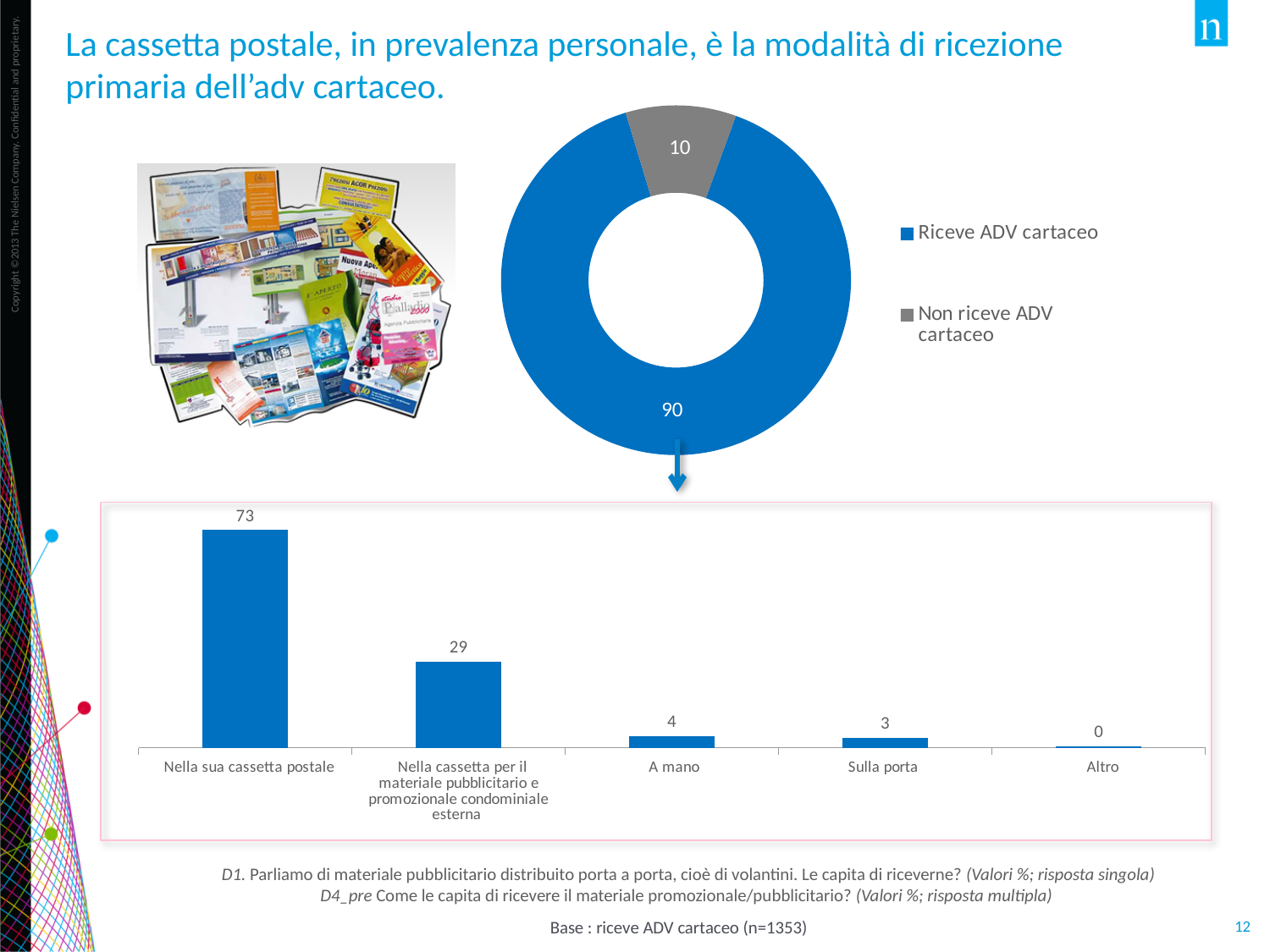
In the bar chart at the bottom of the slide, which category has the highest value? Nella sua cassetta postale In the bar chart at the bottom of the slide, how many categories are shown? 5 In the bar chart at the bottom of the slide, what is the value for "A mano"? 4 In the donut chart at the top of the slide, how many entries does the legend list? 2 What kind of chart is the bottom chart on the slide? Bar chart In the bar chart at the bottom of the slide, what is the difference between "Nella sua cassetta postale" and "Nella cassetta per il materiale pubblicitario e promozionale condominiale esterna"? 44 In the bar chart at the bottom of the slide, which category has the lowest value? Altro In the donut chart at the top of the slide, which segment is larger, "Riceve ADV cartaceo" or "Non riceve ADV cartaceo"? Riceve ADV cartaceo In the donut chart at the top of the slide, what is the value for "Riceve ADV cartaceo"? 90 In the donut chart at the top of the slide, what is the value for "Non riceve ADV cartaceo"? 10 In the donut chart at the top of the slide, what is the difference between the "Riceve ADV cartaceo" and "Non riceve ADV cartaceo" values? 80 In the bar chart at the bottom of the slide, what is the value for "Nella sua cassetta postale"? 73